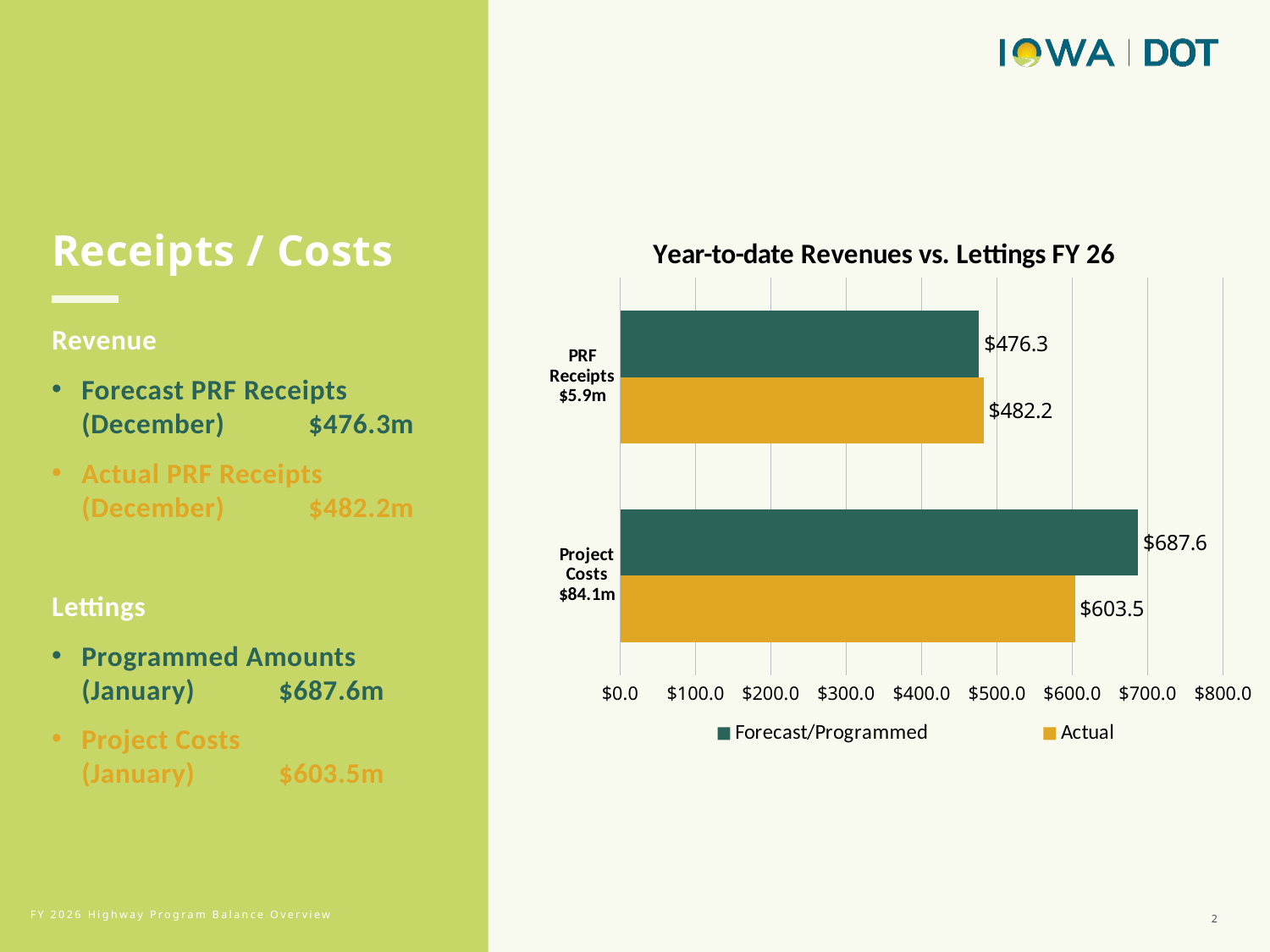
Which category has the highest Forecast/Programmed value? Project Costs How many categories are shown on the chart? 2 What is the difference between the Forecast/Programmed and Actual values for Project Costs? $84.1 Which category has the lowest Actual value? PRF Receipts What is the Forecast/Programmed value for Project Costs? $687.6 What is the difference between the Actual and Forecast/Programmed values for PRF Receipts? $5.9 What is the Actual value for PRF Receipts? $482.2 What is the Actual value for Project Costs? $603.5 For Project Costs, which is larger: the Forecast/Programmed value or the Actual value? Forecast/Programmed What type of chart is shown on the slide? Bar chart How many series does the legend list? 2 What is the Forecast/Programmed value for PRF Receipts? $476.3